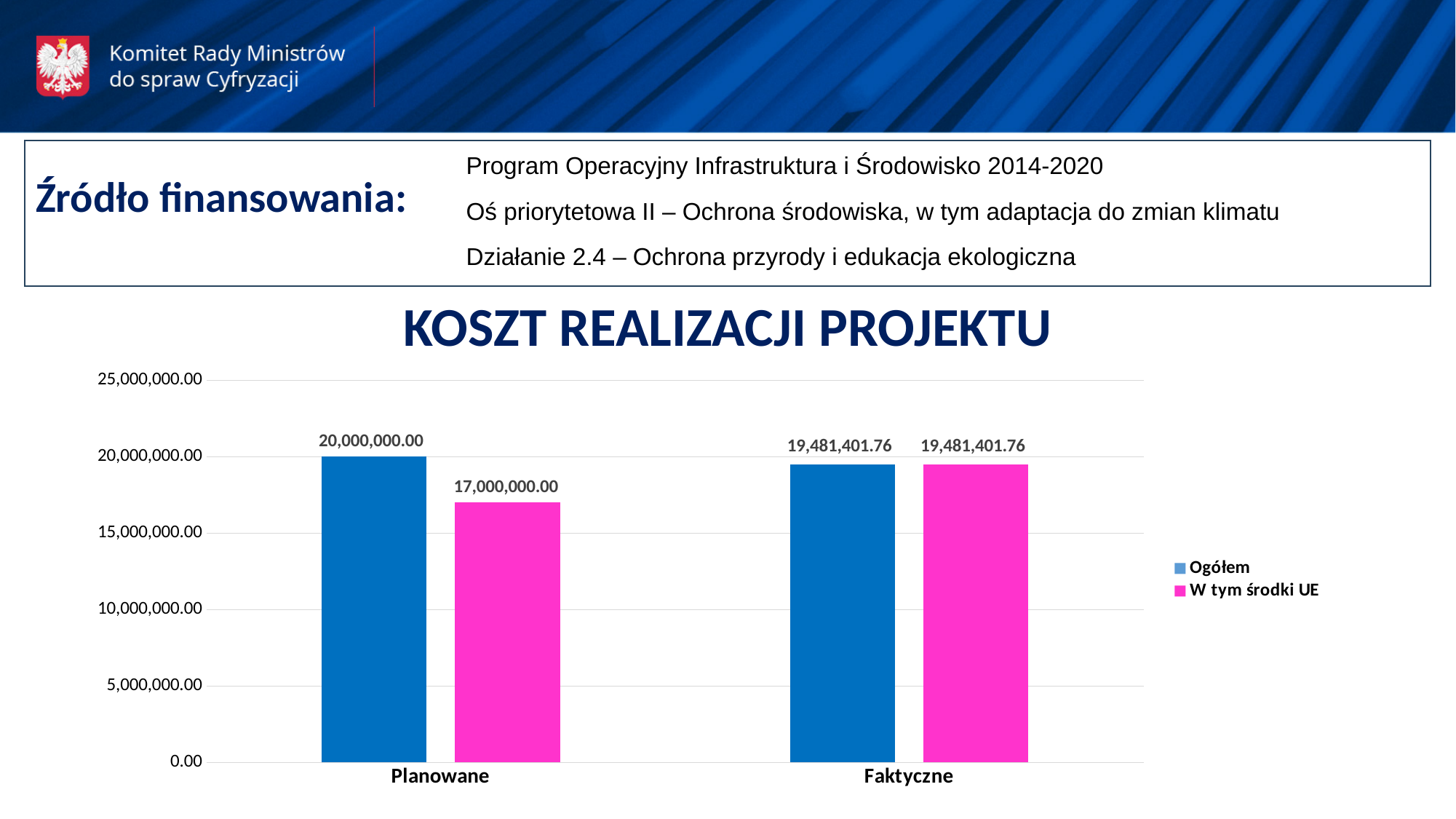
What is the value of Ogółem for Faktyczne? 19,481,401.76 Which is larger: Ogółem for Planowane or Ogółem for Faktyczne? Ogółem for Planowane What type of chart is shown on the slide? bar chart What is the difference between Ogółem and W tym środki UE for Planowane? 3,000,000.00 What is the value of Ogółem for Planowane? 20,000,000.00 Which category has the lowest W tym środki UE value? Planowane How many series does the legend list? 2 Which category has the highest Ogółem value? Planowane Is the value of W tym środki UE for Planowane greater or less than 15,000,000.00? greater What is the value of W tym środki UE for Planowane? 17,000,000.00 How many categories are shown on the x axis? 2 What is the value of W tym środki UE for Faktyczne? 19,481,401.76